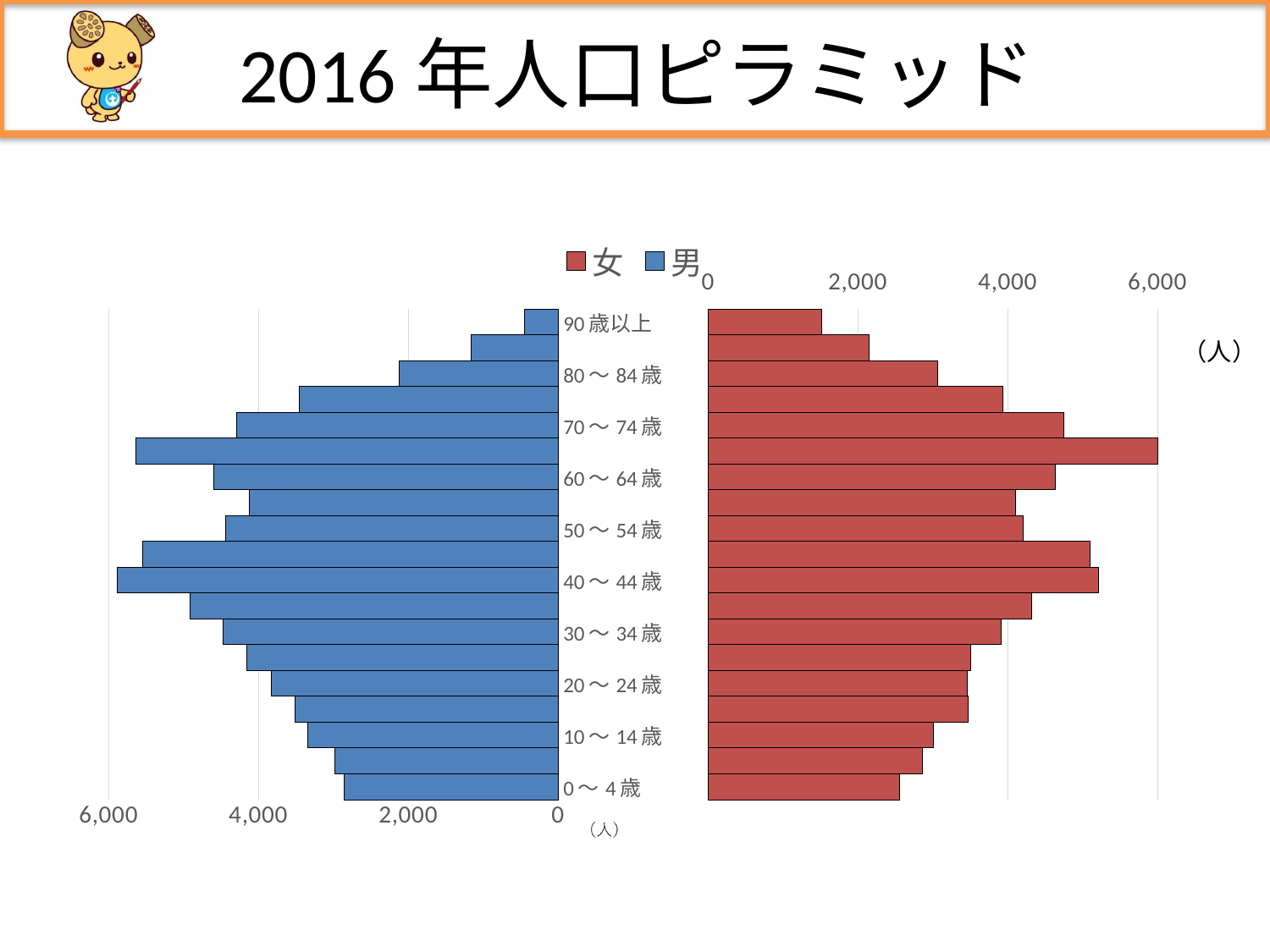
How many series does the legend list? 2 Which age group has the highest value for 女 (female)? 65～69歳 For the 0～4歳 group, which is larger, 女 (female) or 男 (male)? 男 Which colour represents 男 (male) in the chart? blue Is the value for 女 (female) in the 80～84歳 group greater or less than 2,000? greater How many age-group bars are plotted for each series? 19 Which age group has the lowest value for 女 (female)? 90歳以上 What kind of chart is shown on the slide? bar chart Is the value for 男 (male) in the 90歳以上 group greater or less than 2,000? less Which age group has the lowest value for 男 (male)? 90歳以上 For the 90歳以上 group, which is larger, 女 (female) or 男 (male)? 女 Is the value for 男 (male) in the 40～44歳 group greater or less than 4,000? greater